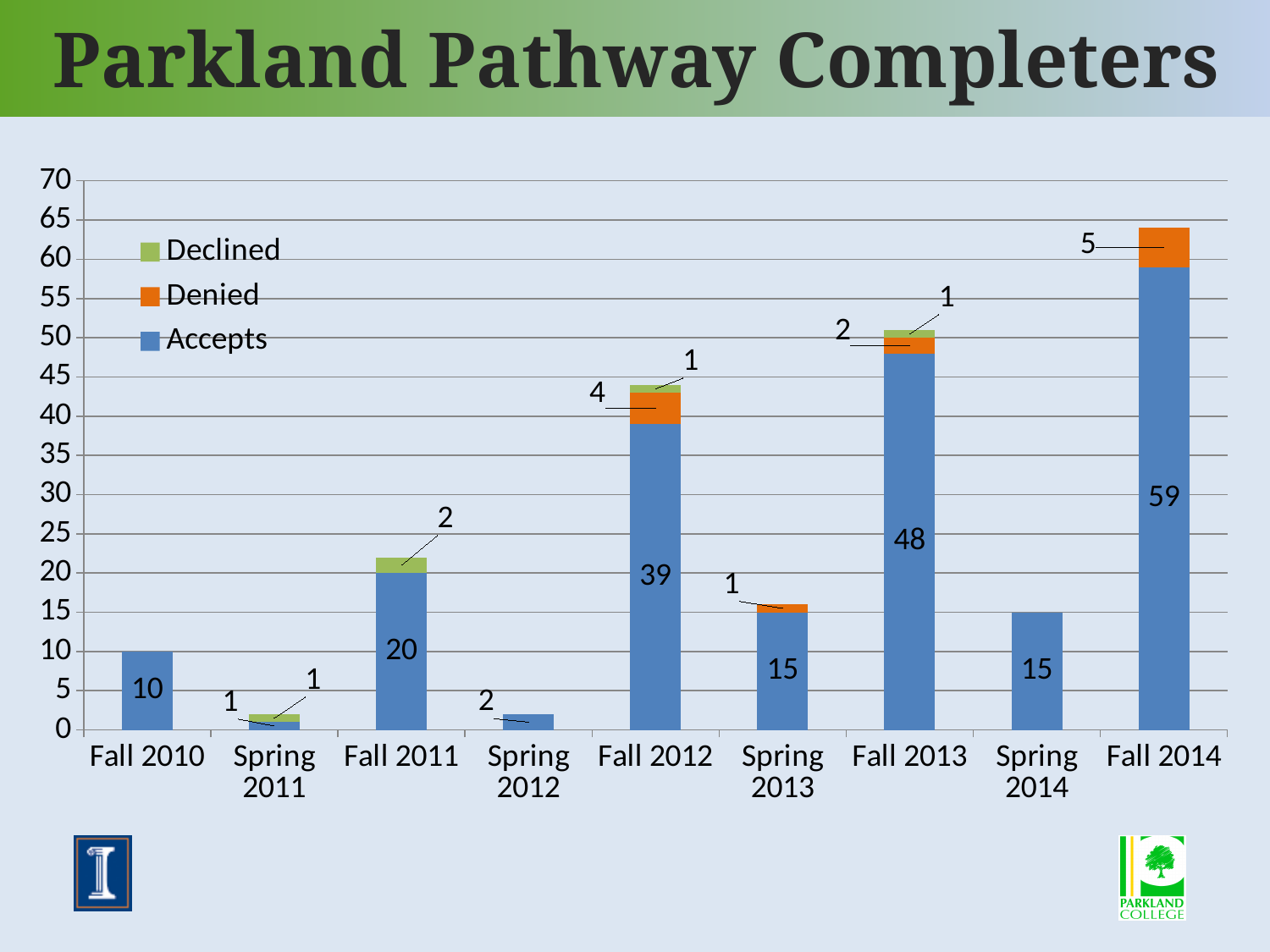
What is the total of the stacked bar for Fall 2012? 44 What is the Denied value for Fall 2012? 4 How many terms (categories) are shown on the x axis? 9 Which term has the highest Accepts value? Fall 2014 What is the difference between the Accepts values for Fall 2014 and Fall 2013? 11 Which series is shown in orange in the legend? Denied What kind of chart is shown on the slide? Stacked bar chart What is the Declined value for Fall 2011? 2 How many series does the legend list? 3 Which is larger, the Accepts value for Fall 2012 or for Fall 2011? Fall 2012 What is the Accepts value for Fall 2014? 59 Which term has the lowest Accepts value? Spring 2011